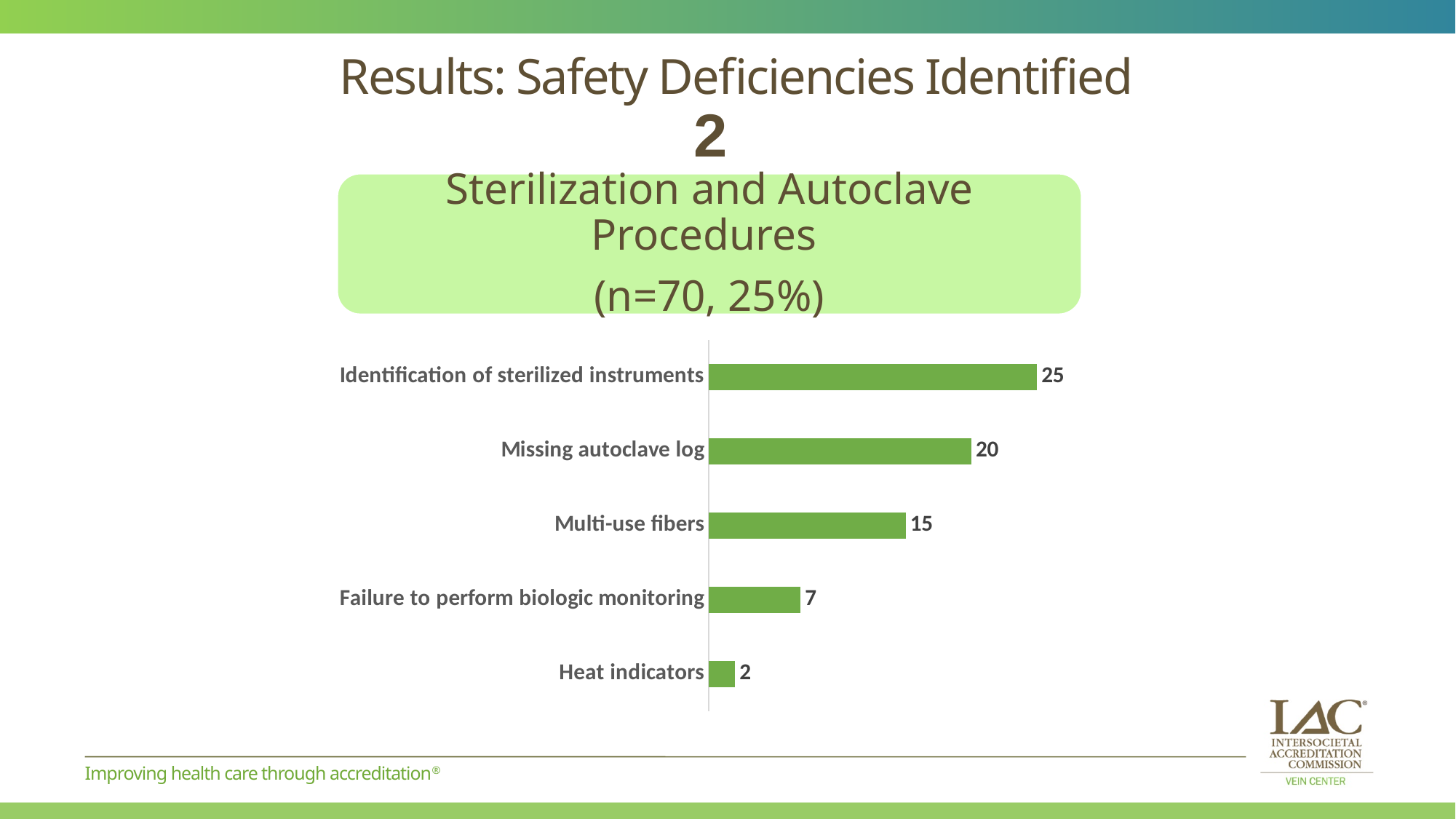
What is the value for Multi-use fibers? 15 What is the value for Failure to perform biologic monitoring? 7 What is the value for Heat indicators? 2 What is the difference between the values for Multi-use fibers and Heat indicators? 13 What is the difference between the values for Identification of sterilized instruments and Missing autoclave log? 5 What kind of chart is shown on the slide? Bar chart What is the value for Identification of sterilized instruments? 25 What is the value for Missing autoclave log? 20 How many categories are shown in the chart? 5 Which category has the lowest value? Heat indicators Which category has the highest value? Identification of sterilized instruments Which is larger, the value for Multi-use fibers or the value for Failure to perform biologic monitoring? Multi-use fibers